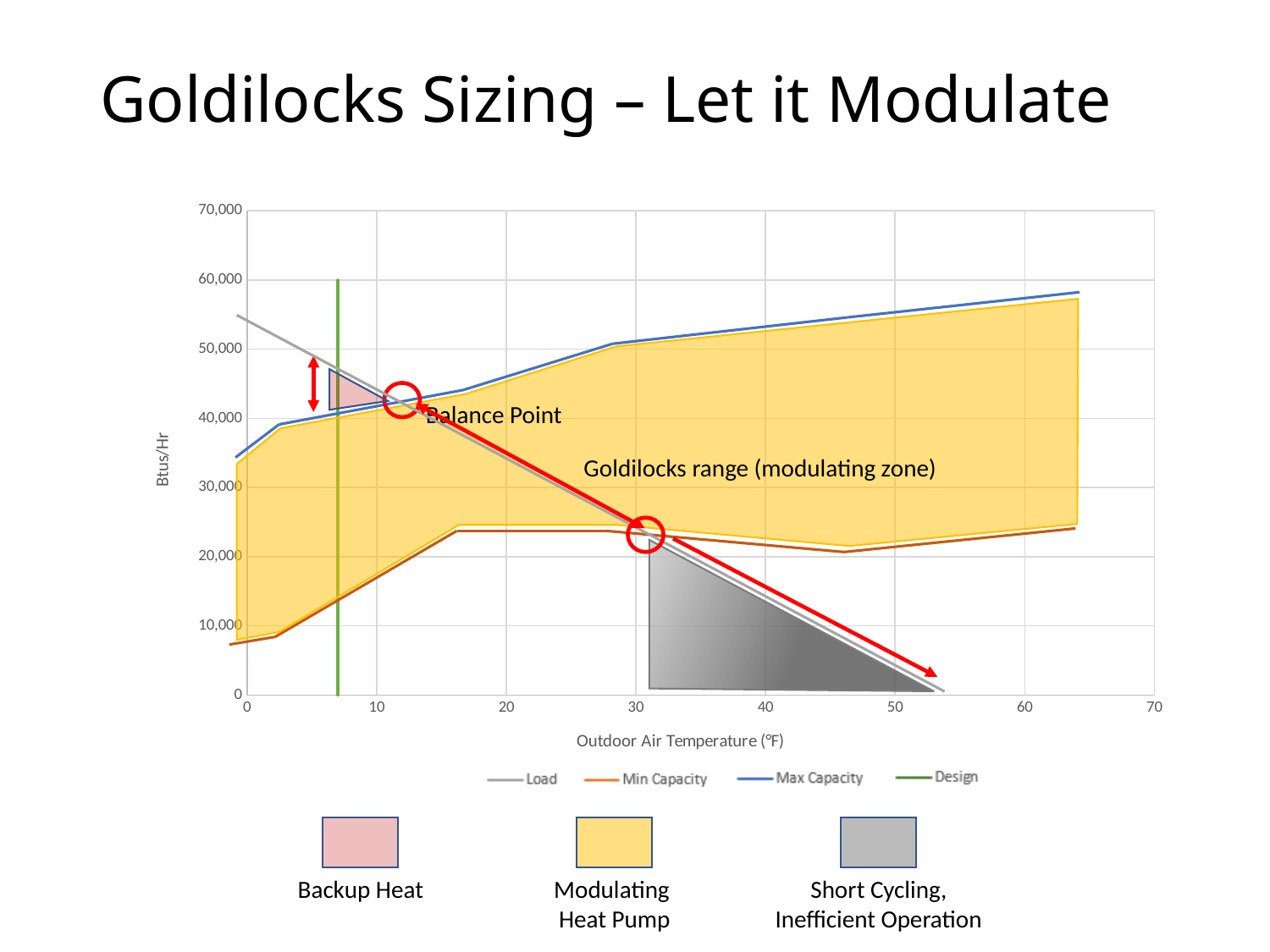
What is the label of the chart's horizontal axis? Outdoor Air Temperature (°F) Does the Load series rise or fall as outdoor air temperature increases? fall What is the label of the chart's vertical axis? Btus/Hr At 0°F, which is larger: Load or Max Capacity? Load Does the Max Capacity series generally rise or fall as outdoor air temperature increases? rise Is the Load value at 0°F greater or less than 50,000? greater At 40°F, which is larger: Max Capacity or Min Capacity? Max Capacity What kind of chart is shown on the slide? line chart Is the Load value at 50°F greater or less than 10,000? less How many series does the chart legend list? 4 Is the Min Capacity value at 40°F greater or less than 30,000? less